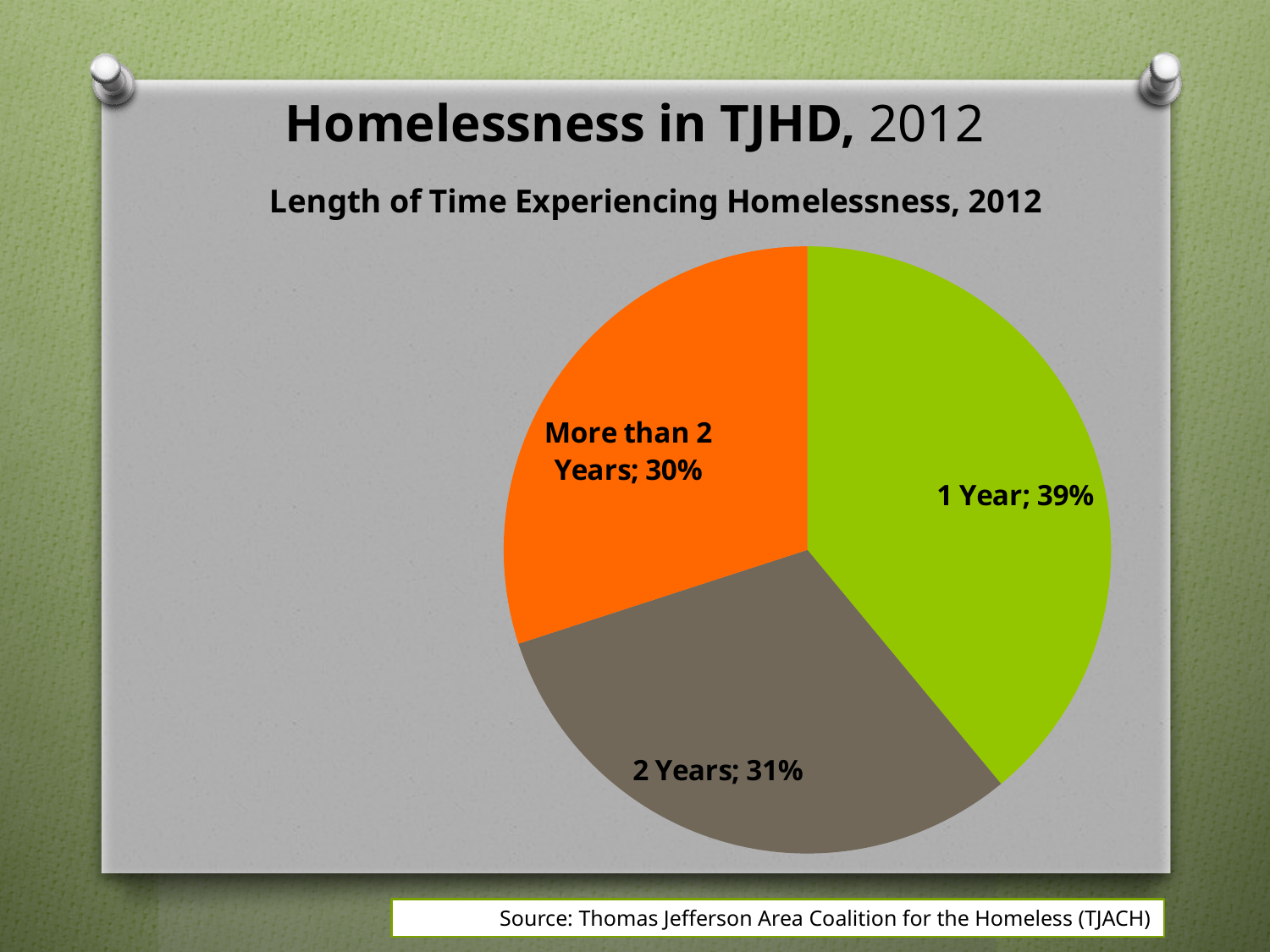
Which category has the smallest slice of the pie? More than 2 Years What kind of chart is shown on the slide? Pie chart What is the difference in percentage points between the "1 Year" slice and the "More than 2 Years" slice? 9 What share of the pie is labelled "2 Years"? 31% What is the title of the chart? Length of Time Experiencing Homelessness, 2012 How many slices does the pie chart have? 3 What share of the pie is labelled "More than 2 Years"? 30% What is the difference in percentage points between the "1 Year" slice and the "2 Years" slice? 8 Which category has the largest slice of the pie? 1 Year Which is larger, the "1 Year" slice or the "2 Years" slice? 1 Year What share of the pie is labelled "1 Year"? 39% What colour is the "2 Years" slice? Grey